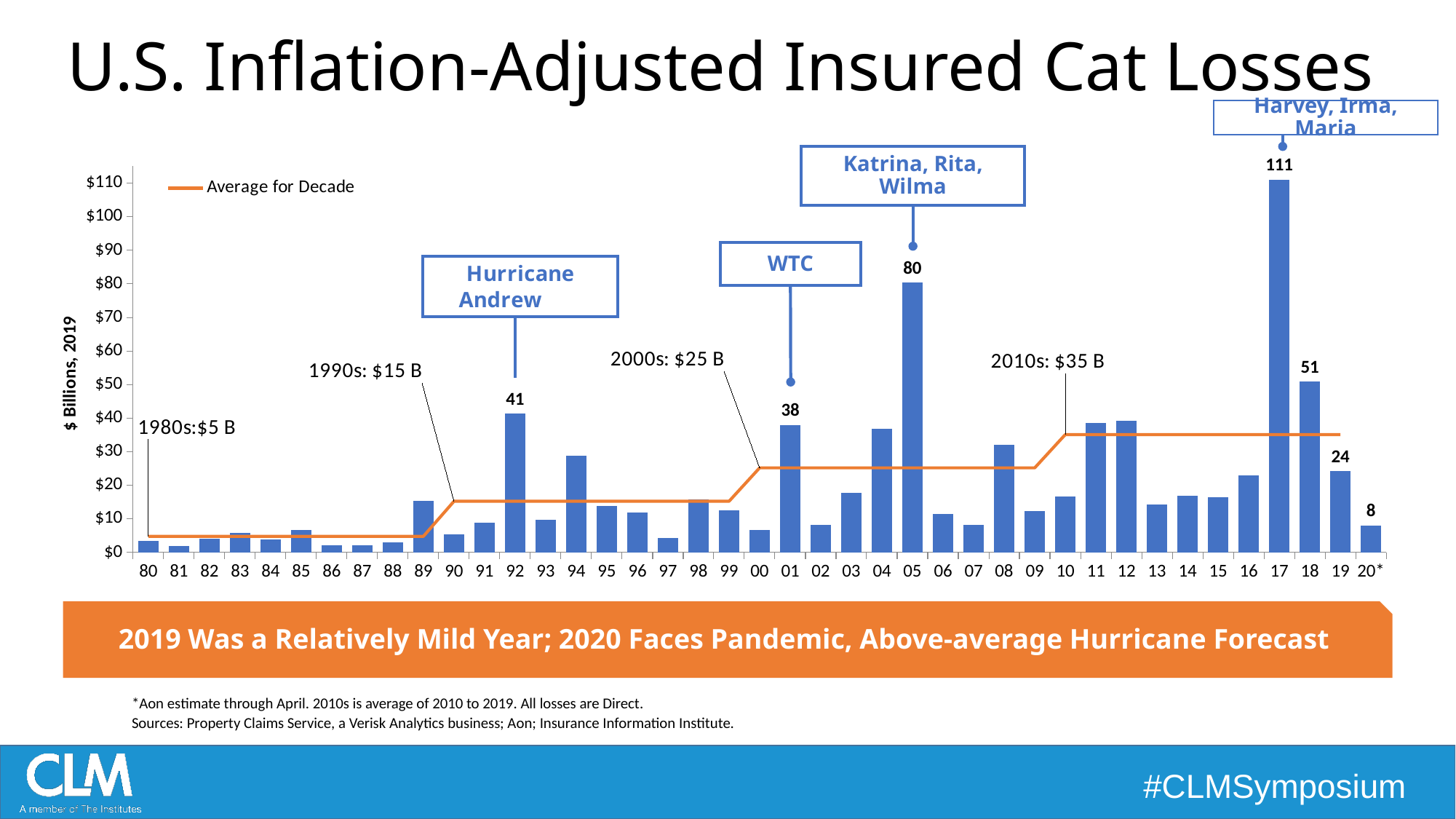
What is the difference between the 2018 value and the 2019 value? 27 What is the difference between the 2017 value and the 2005 value? 31 What is the value for 2019 in the chart? 24 Which is larger, the value for 2005 or the value for 2018? 2005 What is the value for 2017 in the U.S. Inflation-Adjusted Insured Cat Losses chart? 111 What is the average for the 2010s decade shown on the chart? $35 B Is the value for 2011 greater or less than $30? greater What is the value for 2005 in the chart? 80 Which year has the highest insured cat losses in the chart? 2017 What kind of chart is shown on the slide? combination bar and line chart What is the value for 1992, the Hurricane Andrew year? 41 Is the value for 1994 greater or less than $30? less